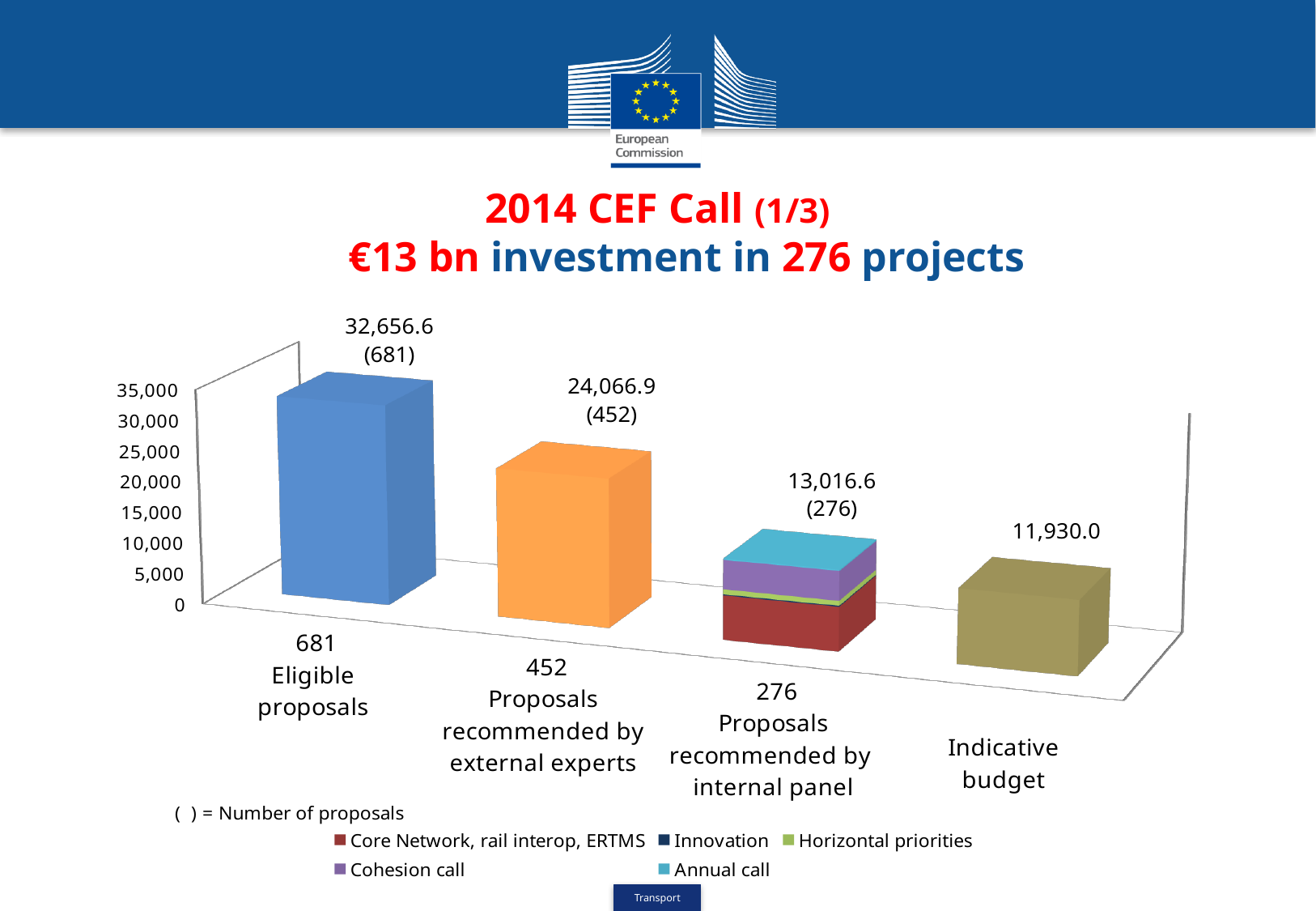
What kind of chart is shown on the slide? Bar chart Which category has the lowest value? Indicative budget How many proposals are shown in parentheses for Proposals recommended by external experts? 452 What is the total value shown for Proposals recommended by internal panel? 13,016.6 What is the value shown for Indicative budget? 11,930.0 What is the difference between the value for Eligible proposals and the value for Proposals recommended by external experts? 8,589.7 What is the value shown for Proposals recommended by external experts? 24,066.9 Which category has the highest value? Eligible proposals Which is larger: the value for Proposals recommended by internal panel or the Indicative budget? Proposals recommended by internal panel How many series does the legend list? 5 How many categories are shown on the x axis? 4 What is the value shown for Eligible proposals? 32,656.6